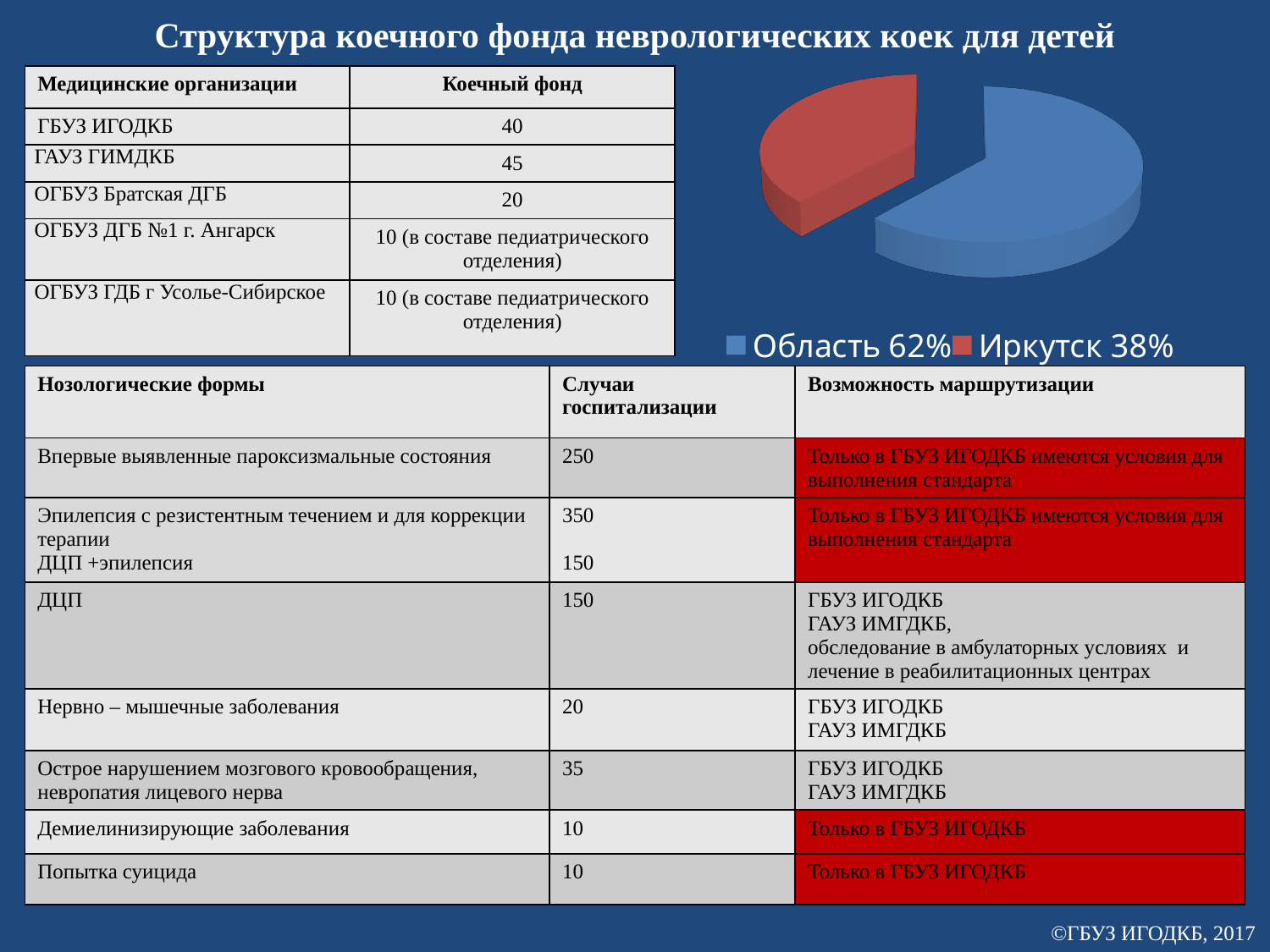
Which slice of the pie chart is the smallest? Иркутск How many slices does the pie chart have? 2 What colour is the Иркутск slice in the pie chart? red What share of the pie chart does Область account for? 62% What colour is the Область slice in the pie chart? blue How many entries does the pie chart's legend list? 2 What kind of chart is shown on the slide? pie chart Which is larger in the pie chart, Область or Иркутск? Область By how many percentage points does the Область share exceed the Иркутск share in the pie chart? 24 Which slice of the pie chart is the largest? Область What share of the pie chart does Иркутск account for? 38%